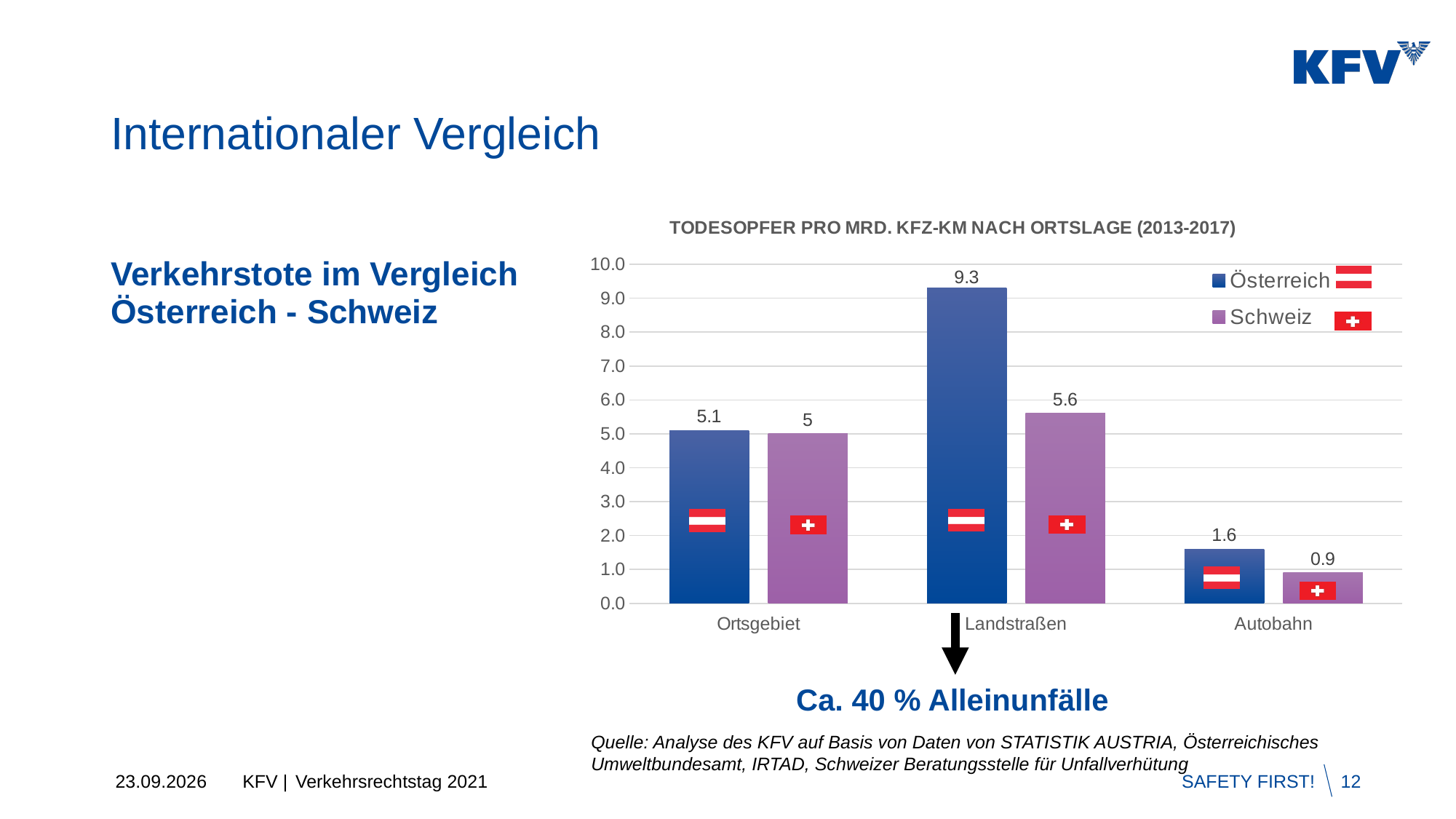
What is the value for Schweiz in the Ortsgebiet category? 5 How many series does the legend list? 2 How many categories are shown on the x axis? 3 What is the value for Schweiz in the Autobahn category? 0.9 Which category has the lowest value for Schweiz? Autobahn Is the value for Schweiz in the Landstraßen category greater or less than 5.0? greater What is the title of the chart? TODESOPFER PRO MRD. KFZ-KM NACH ORTSLAGE (2013-2017) What is the value for Österreich in the Landstraßen category? 9.3 Which is larger in the Autobahn category, the value for Österreich or for Schweiz? Österreich What kind of chart is shown on the slide? bar chart What is the difference between the Österreich and Schweiz values for Landstraßen? 3.7 Which category has the highest value for Österreich? Landstraßen